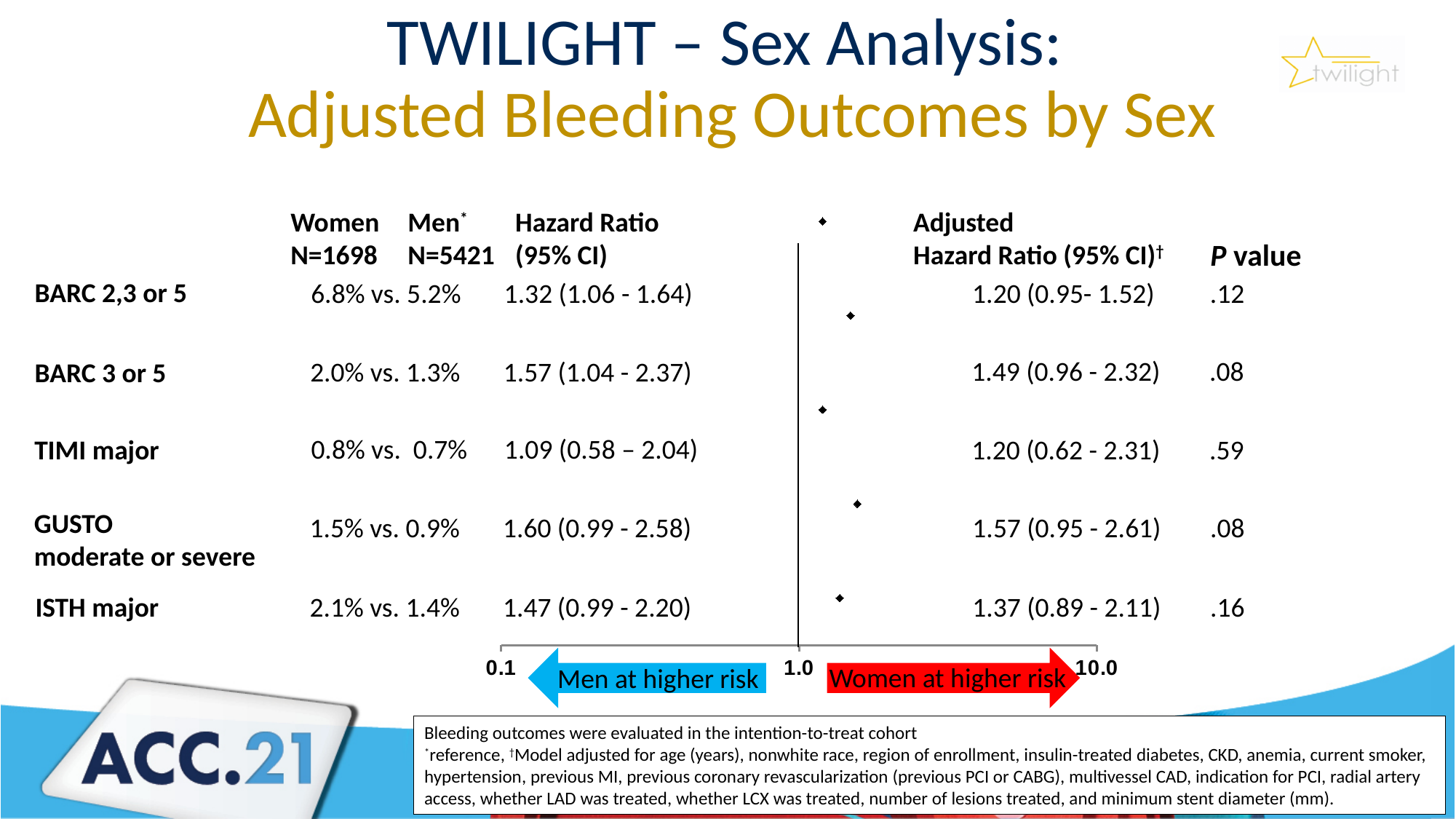
Is the adjusted hazard ratio point for ISTH major greater or less than 1.0 on the forest plot axis? greater Is the adjusted hazard ratio for BARC 3 or 5 larger or smaller than that for ISTH major? larger What kind of chart is shown on the slide? Forest plot According to the axis labels, which side of the 1.0 line indicates women at higher risk? Right side What is the adjusted hazard ratio (95% CI) for BARC 2,3 or 5 bleeding? 1.20 (0.95- 1.52) What is the unadjusted hazard ratio (95% CI) for ISTH major bleeding? 1.47 (0.99 - 2.20) Which bleeding outcome has the highest adjusted hazard ratio? GUSTO moderate or severe How many bleeding outcomes are plotted in the forest plot? 5 What is the adjusted hazard ratio (95% CI) for GUSTO moderate or severe bleeding? 1.57 (0.95 - 2.61) What are the event rates for women vs. men for BARC 3 or 5 bleeding? 2.0% vs. 1.3% Which bleeding outcome has the lowest unadjusted hazard ratio? TIMI major What is the P value for the adjusted hazard ratio of TIMI major bleeding? .59